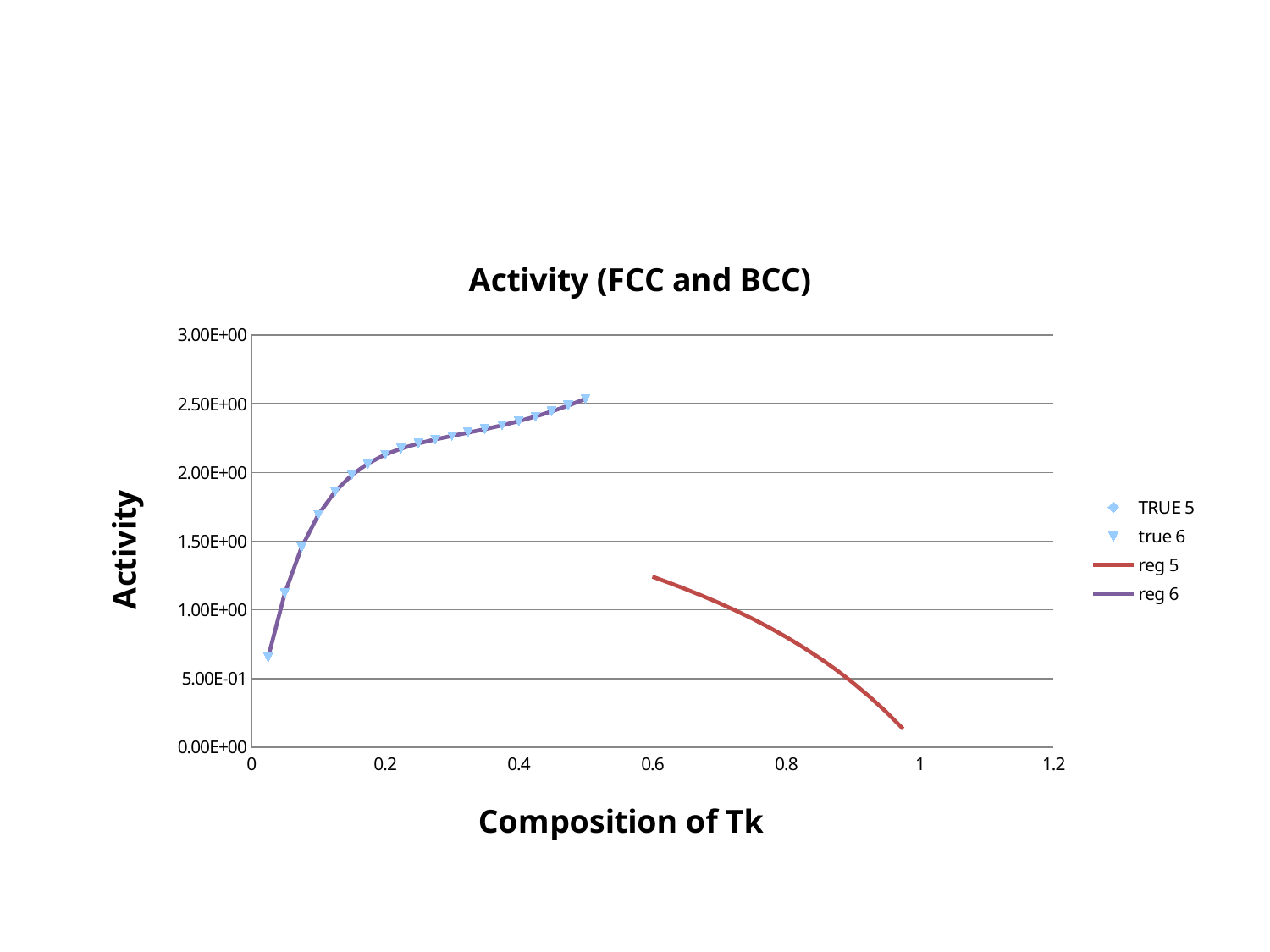
Is the value of the reg 6 curve at a composition of 0.1 greater or less than 1.50E+00? greater Does the reg 5 curve rise or fall as Composition of Tk increases? Falls Is the value of the reg 6 curve at a composition of 0.4 greater or less than 2.00E+00? greater What is the label of the x axis? Composition of Tk Is the value of the reg 5 curve at a composition of 0.6 greater or less than 1.00E+00? greater How many series does the legend list? 4 Which curve reaches higher Activity values, reg 5 or reg 6? reg 6 What is the title of the chart? Activity (FCC and BCC) Which series occupies the higher range of Composition of Tk, reg 5 or reg 6? reg 5 Does the reg 6 curve rise or fall as Composition of Tk increases? Rises What kind of chart is shown on the slide? Line chart (scatter with lines)